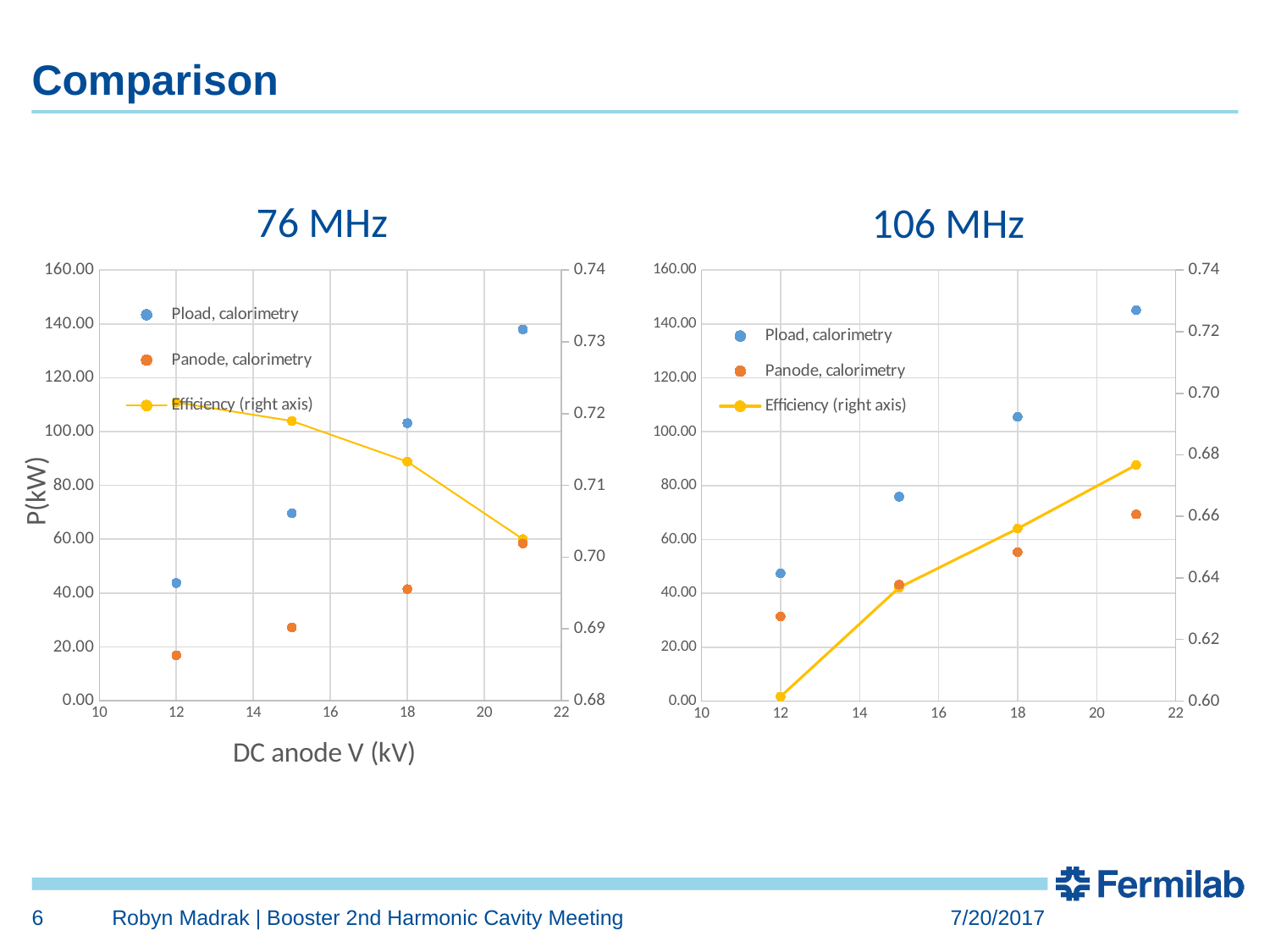
In the 76 MHz chart, at which DC anode voltage is Pload, calorimetry highest? 21 In the 76 MHz chart, how many series does the legend list? 3 In the 106 MHz chart, does the Efficiency (right axis) series rise or fall as DC anode V increases? rise In the 106 MHz chart, how many data points are plotted for the Pload, calorimetry series? 4 In the 76 MHz chart, is the Panode, calorimetry value at 12 kV greater or less than 20? less In the 106 MHz chart, at which DC anode voltage is Panode, calorimetry lowest? 12 In the 106 MHz chart, at 18 kV, which is larger: Pload, calorimetry or Panode, calorimetry? Pload, calorimetry In the 76 MHz chart, is the Pload, calorimetry value at 21 kV greater or less than 120? greater What is the x-axis title of the 76 MHz chart? DC anode V (kV) In the 106 MHz chart, is the Efficiency value at 12 kV greater or less than 0.62? less In the 76 MHz chart, does the Efficiency (right axis) series rise or fall as DC anode V increases? fall